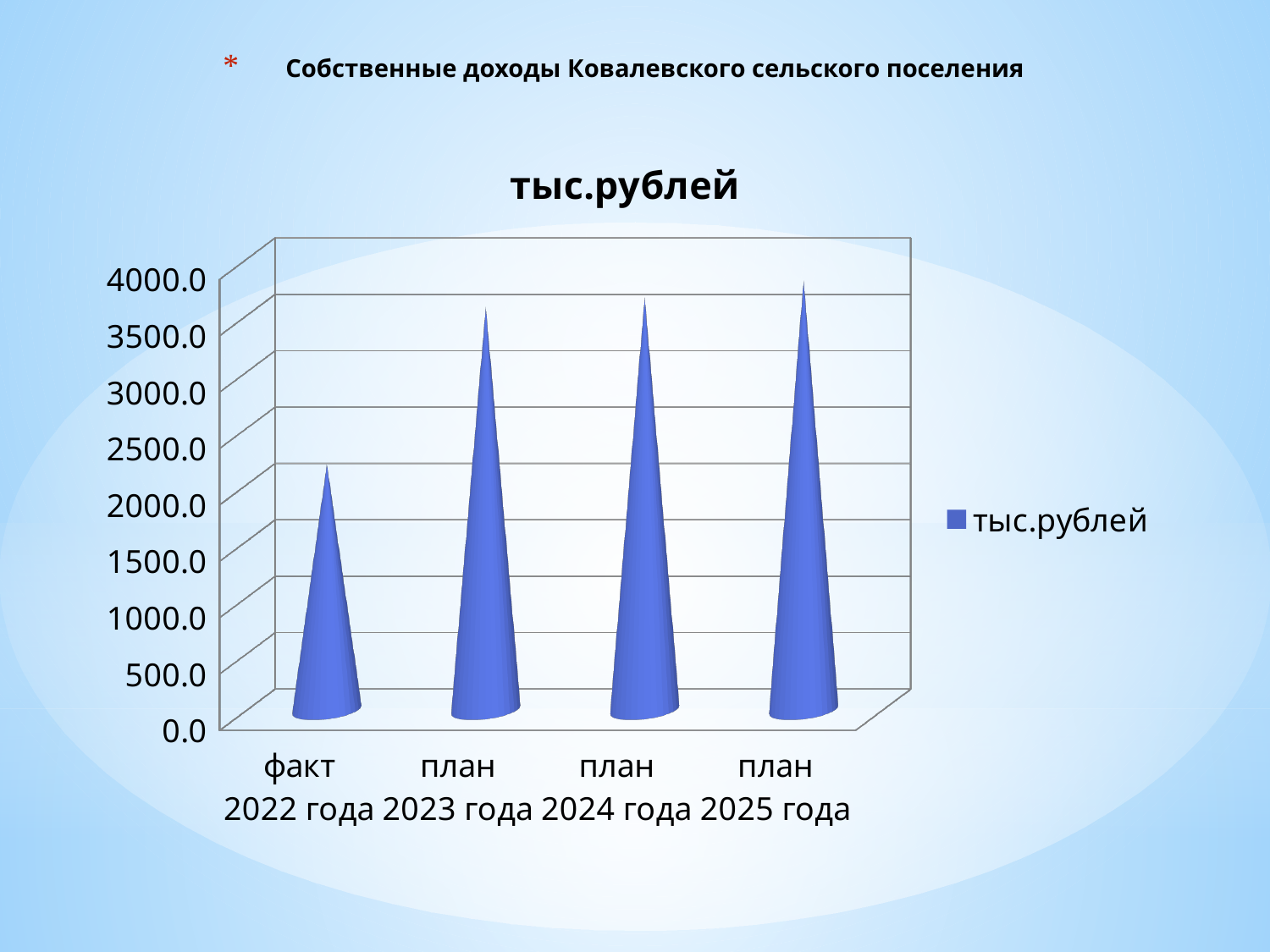
What kind of chart is shown on the slide? bar chart Is the value for факт 2022 года greater or less than 2500? less Is the value for план 2023 года greater or less than 3500? greater What is the name of the series shown in the legend? тыс.рублей Which is larger, the value for факт 2022 года or the value for план 2023 года? план 2023 года What is the title of the chart? тыс.рублей Is the value for план 2024 года greater or less than 3000? greater Do the values rise or fall from факт 2022 года to план 2025 года along the x axis? rise How many categories are plotted along the x axis of the chart? 4 Which category has the lowest value in the chart? факт 2022 года How many series does the chart legend list? 1